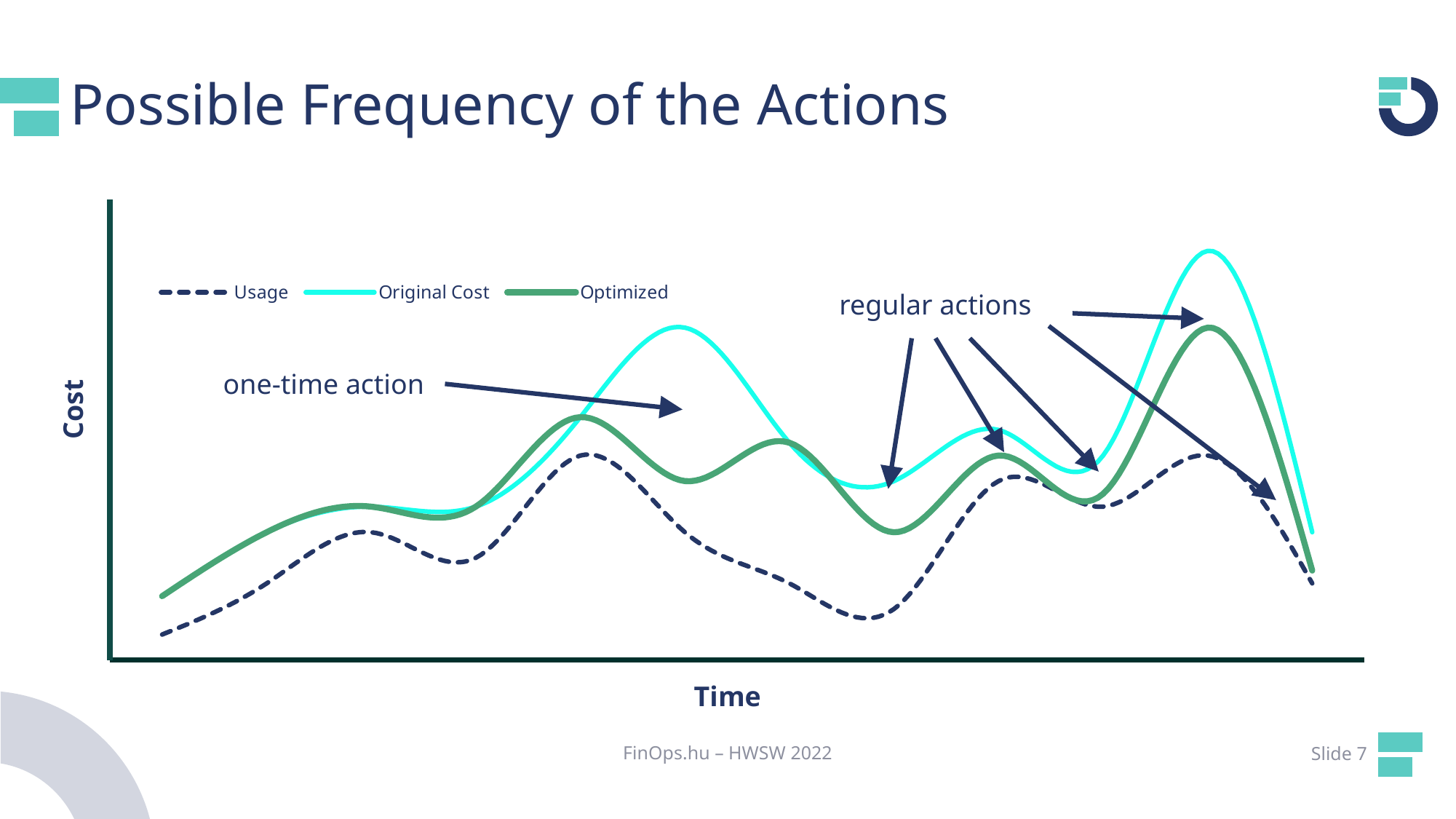
What label is on the vertical axis of the chart? Cost Which series is drawn in the bright cyan colour? Original Cost At the tallest peak near the right of the chart, which is higher: Original Cost or Optimized? Original Cost What kind of chart is shown on the slide? line chart Which series reaches the highest point on the chart? Original Cost How many series does the legend list? 3 Which series is drawn in the darker green colour? Optimized Which series is drawn as a dashed line? Usage Which series is plotted lowest on the chart for most of the time axis? Usage At the first peak on the left, which is higher: Optimized or Usage? Optimized